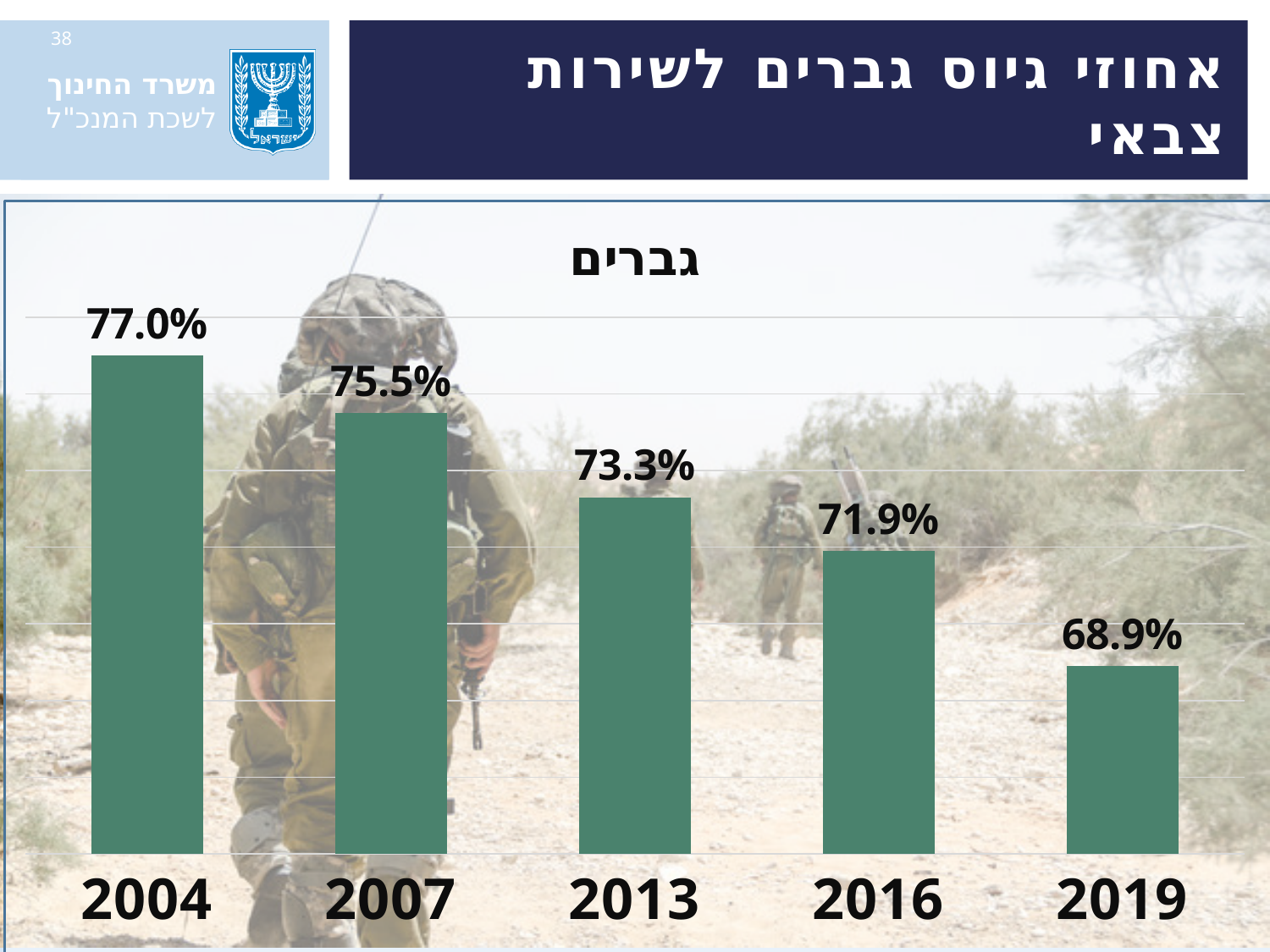
Which is larger, the value for 2007 or the value for 2016? 2007 What is the value for 2004? 77.0% Which year has the lowest value? 2019 Do the values rise or fall from 2004 to 2019? Fall What is the difference between the values for 2004 and 2019? 8.1% What is the value for 2013? 73.3% What kind of chart is shown on the slide? Bar chart Which year has the highest value? 2004 How many years are shown on the chart? 5 What is the difference between the values for 2007 and 2013? 2.2% What is the value for 2016? 71.9% What is the value for 2019? 68.9%